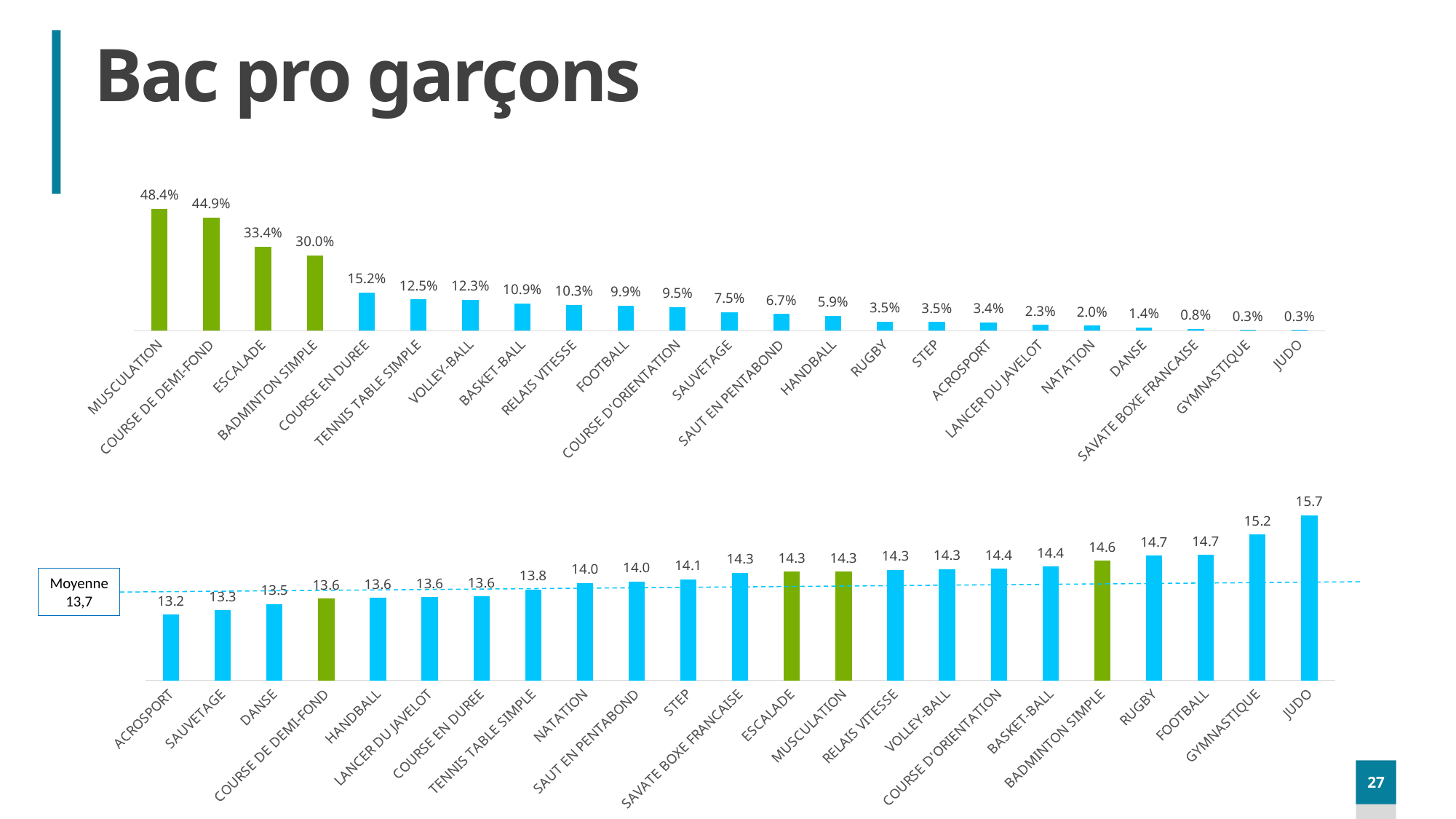
In the top chart, how many categories are shown? 23 In the top chart, what is the difference between the values for MUSCULATION and COURSE DE DEMI-FOND? 3.5% What kind of chart is the bottom chart? bar chart In the bottom chart, do the values rise or fall from left to right along the x axis? rise In the top chart, which is larger, the value for FOOTBALL or the value for SAUVETAGE? FOOTBALL In the top chart, what is the value for MUSCULATION? 48.4% In the top chart, which category has the highest value? MUSCULATION In the bottom chart, what is the value for JUDO? 15.7 In the bottom chart, which category has the lowest value? ACROSPORT In the top chart, what is the value for COURSE EN DUREE? 15.2% In the bottom chart, what is the difference between the values for JUDO and ACROSPORT? 2.5 In the bottom chart, what value does the dashed 'Moyenne' line represent? 13,7